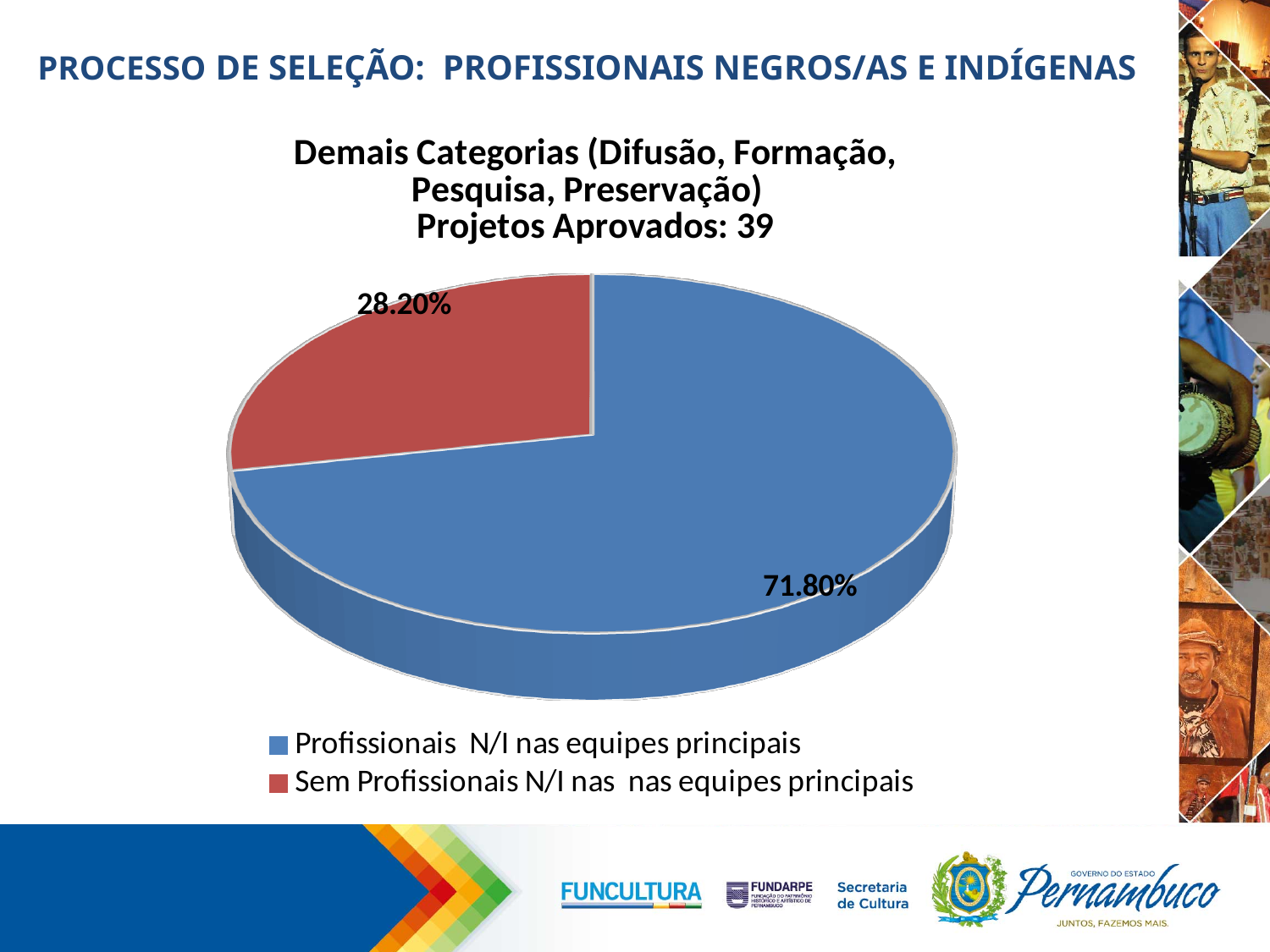
What kind of chart is shown on the slide? Pie chart What percentage of the pie is labelled for 'Sem Profissionais N/I nas nas equipes principais'? 28.20% What share of the pie does the blue slice represent? 71.80% Which slice of the pie is the largest? Profissionais N/I nas equipes principais How many slices does the pie chart have? 2 What colour is the slice for 'Sem Profissionais N/I nas nas equipes principais'? Red What is the difference in percentage points between the two slices of the pie? 43.60% What percentage of the pie is labelled for 'Profissionais N/I nas equipes principais'? 71.80% How many entries does the legend list? 2 Which is larger: the slice for 'Profissionais N/I nas equipes principais' or the slice for 'Sem Profissionais N/I nas nas equipes principais'? Profissionais N/I nas equipes principais According to the chart title, how many projects were approved (Projetos Aprovados)? 39 Which slice of the pie is the smallest? Sem Profissionais N/I nas nas equipes principais